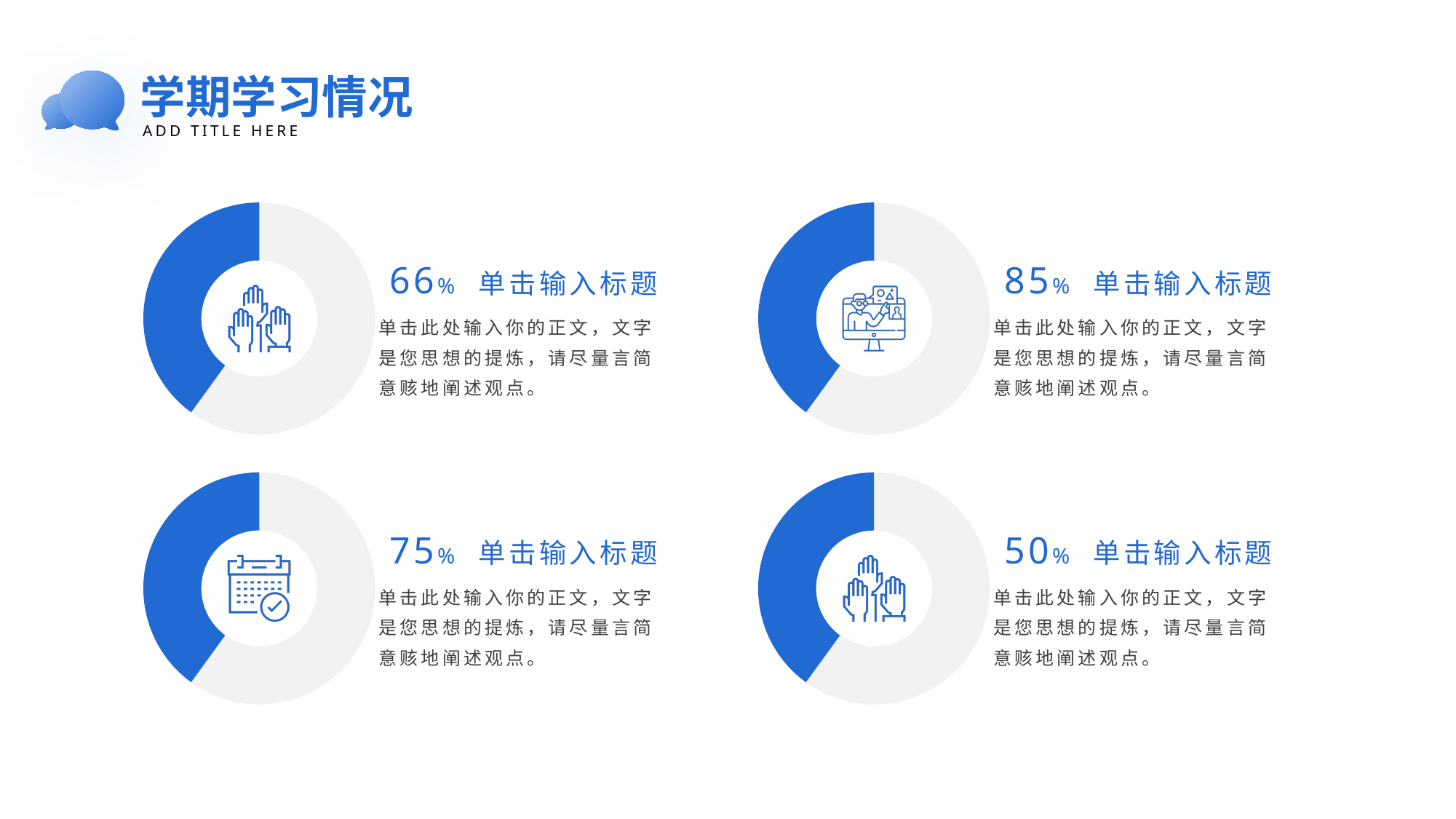
What is the difference between the percentages of the top-left and top-right charts? 19% What is the title of the slide containing the four donut charts? 学期学习情况 What percentage is shown next to the top-left donut chart? 66% Which of the four donut charts has the highest printed percentage? Top-right (85%) Which is larger, the percentage of the top-left chart or the percentage of the bottom-left chart? Bottom-left (75%) What is the difference between the percentage of the top-right chart and the percentage of the bottom-right chart? 35% What percentage is shown next to the bottom-right donut chart? 50% What percentage is shown next to the top-right donut chart? 85% How many donut charts are on the slide? 4 Which of the four donut charts has the lowest printed percentage? Bottom-right (50%) What percentage is shown next to the bottom-left donut chart? 75% What kind of chart is used for each of the four figures on the slide? Donut chart